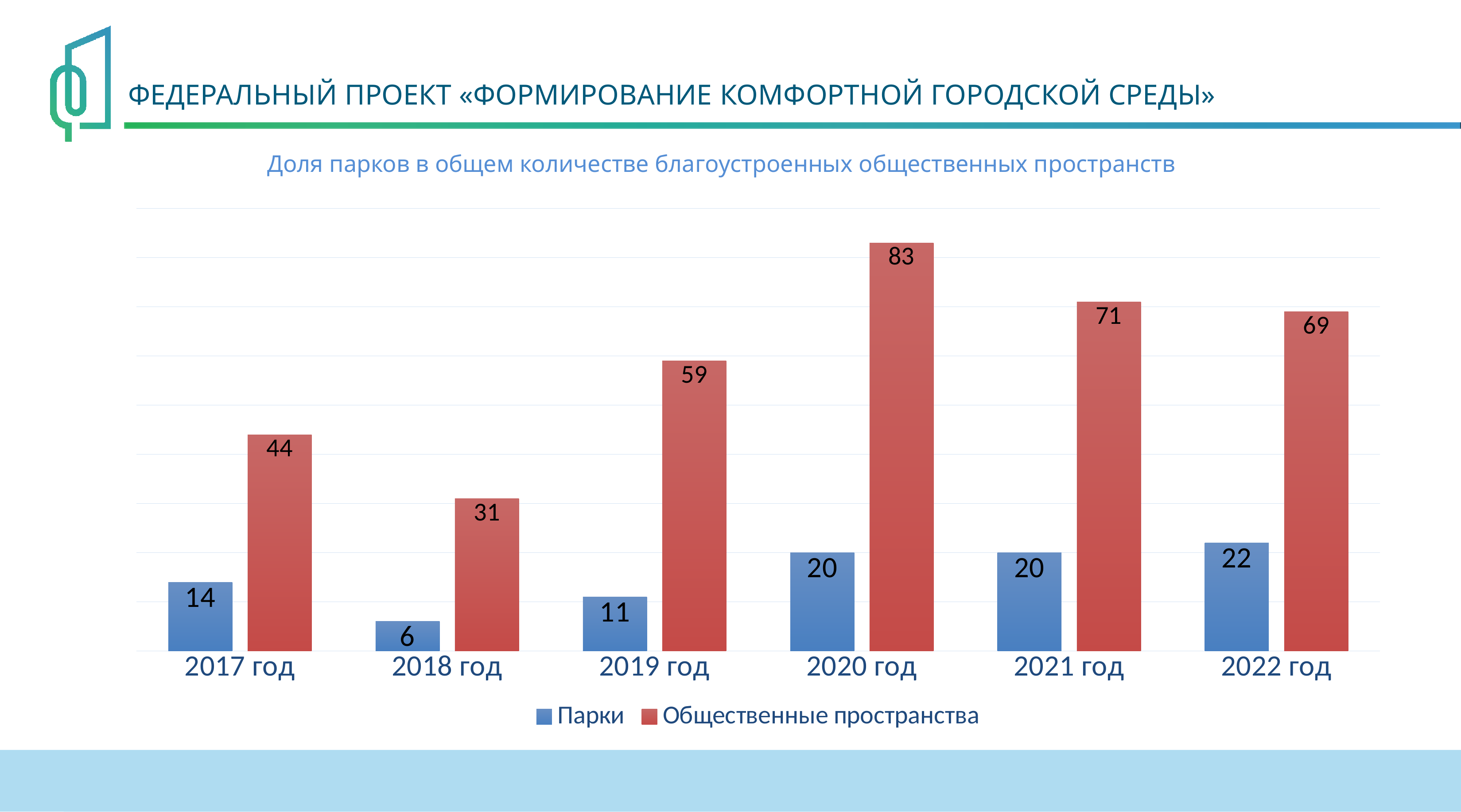
What is the value for Общественные пространства in 2020 год? 83 What is the difference between Общественные пространства and Парки in 2019 год? 48 Does the value for Общественные пространства rise or fall from 2018 год to 2020 год? Rise What is the value for Парки in 2017 год? 14 How many years are shown on the x axis? 6 What is the title of the chart? Доля парков в общем количестве благоустроенных общественных пространств How many series does the legend list? 2 In which year is the value for Парки lowest? 2018 год What kind of chart is shown on the slide? Bar chart Which is larger: Общественные пространства in 2021 год or in 2022 год? 2021 год In which year is the value for Общественные пространства highest? 2020 год What is the value for Парки in 2022 год? 22